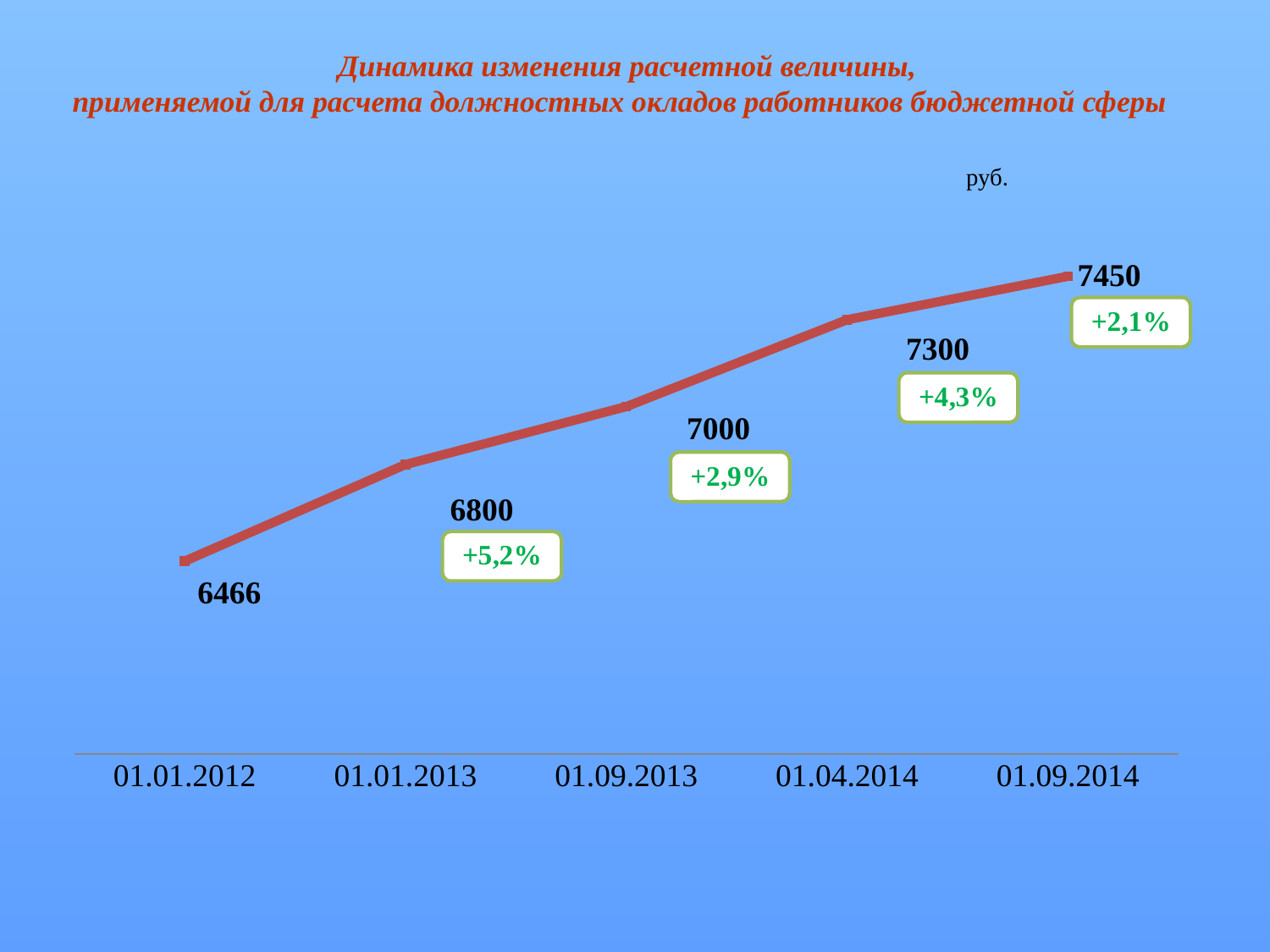
What kind of chart is shown on the slide? line chart What is the value for 01.01.2012? 6466 What is the value for 01.09.2014? 7450 Which is larger, the value for 01.09.2013 or the value for 01.01.2013? 01.09.2013 How many data points are plotted on the line? 5 Do the values rise or fall from 01.01.2012 to 01.09.2014? rise What is the difference between the values for 01.01.2013 and 01.01.2012? 334 Which date has the lowest value? 01.01.2012 What is the value for 01.04.2014? 7300 Which date has the highest value? 01.09.2014 What is the value for 01.09.2013? 7000 What is the difference between the values for 01.09.2014 and 01.04.2014? 150